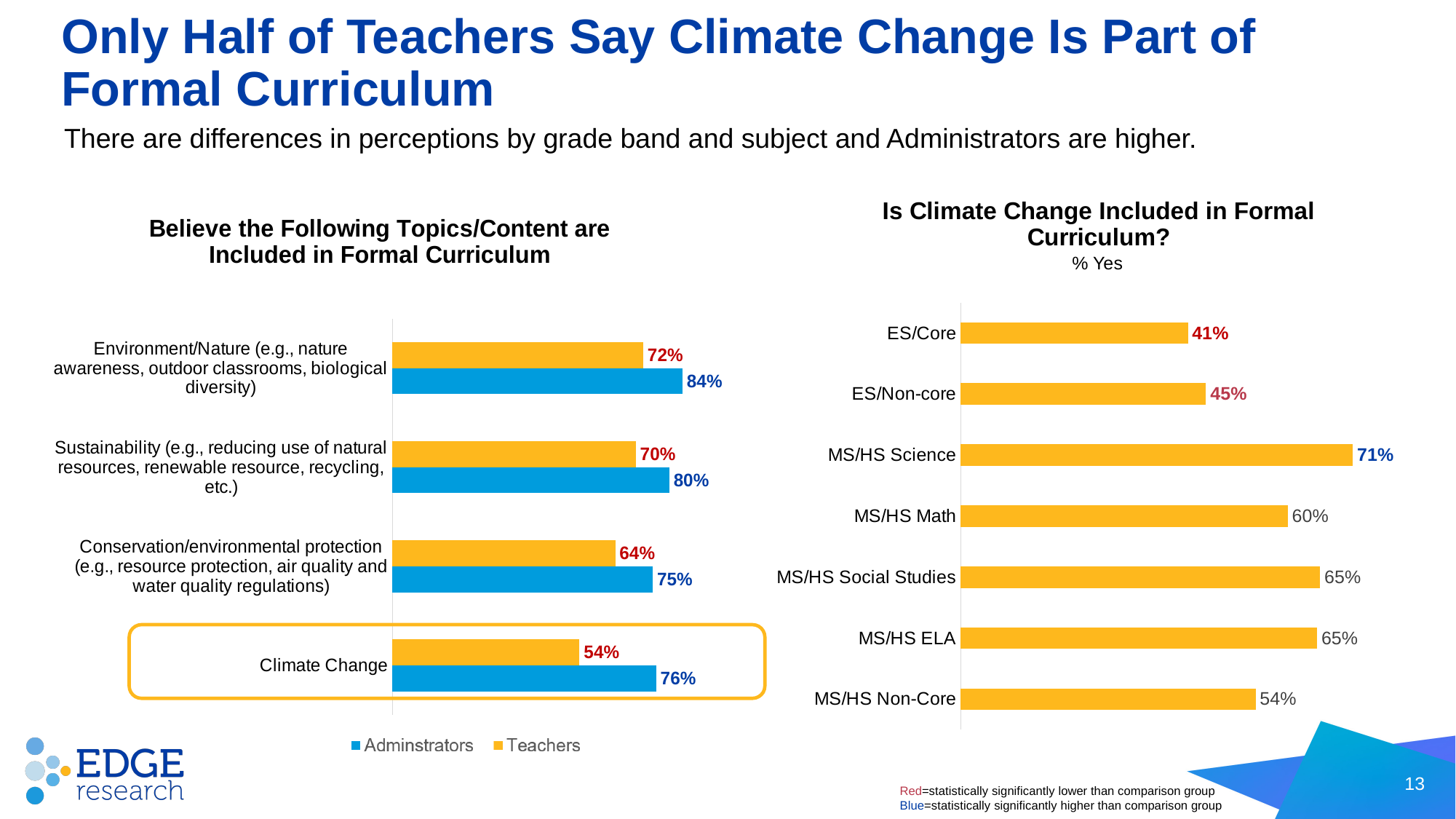
In the 'Is Climate Change Included in Formal Curriculum?' chart, what is the difference between MS/HS Science and ES/Core? 30% What type of chart is the 'Is Climate Change Included in Formal Curriculum?' chart? Bar chart In the 'Believe the Following Topics/Content are Included in Formal Curriculum' chart, what percentage of Administrators believe Environment/Nature is included? 84% In the 'Believe the Following Topics/Content are Included in Formal Curriculum' chart, how many series does the legend list? 2 In the 'Believe the Following Topics/Content are Included in Formal Curriculum' chart, which is larger for Sustainability: Administrators or Teachers? Administrators In the 'Is Climate Change Included in Formal Curriculum?' chart, how many groups are shown? 7 In the 'Believe the Following Topics/Content are Included in Formal Curriculum' chart, which topic has the lowest Teachers value? Climate Change In the 'Is Climate Change Included in Formal Curriculum?' chart, what is the value for MS/HS Science? 71% In the 'Is Climate Change Included in Formal Curriculum?' chart, which group has the lowest value? ES/Core In the 'Believe the Following Topics/Content are Included in Formal Curriculum' chart, what is the difference between Administrators and Teachers for Climate Change? 22% In the 'Believe the Following Topics/Content are Included in Formal Curriculum' chart, what percentage of Teachers believe Climate Change is included? 54% In the 'Is Climate Change Included in Formal Curriculum?' chart, which group has the highest value? MS/HS Science